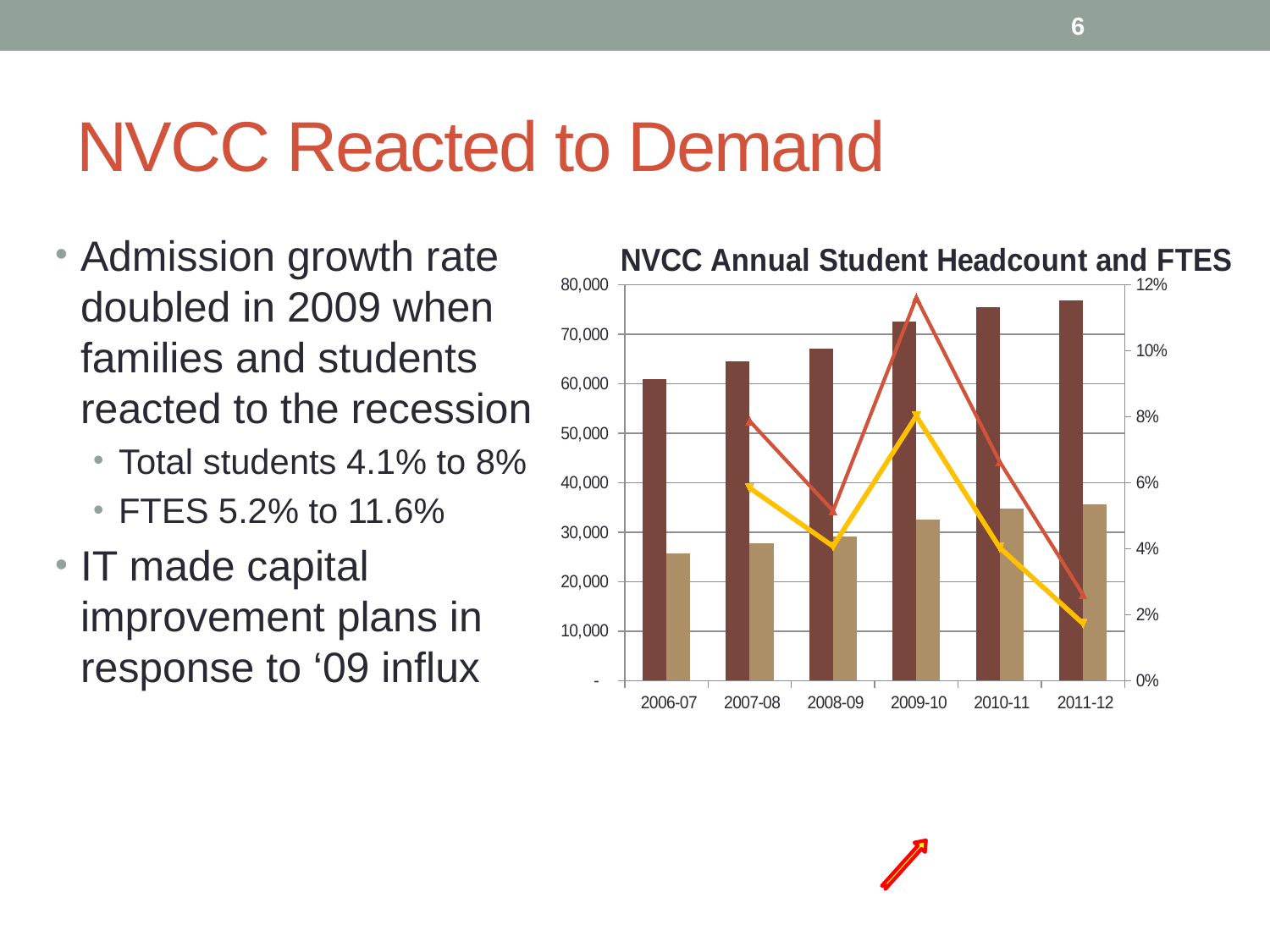
Do the tan bars rise or fall from 2006-07 to 2011-12? rise Do the dark brown bars rise or fall from 2006-07 to 2011-12? rise In which year are the dark brown bars highest? 2011-12 What kind of chart is shown on the slide? A combination bar and line chart Is the dark brown bar for 2009-10 greater or less than 70,000? greater How many academic years are shown on the x axis of the chart? 6 In which year are the dark brown bars lowest? 2006-07 Is the tan bar for 2011-12 greater or less than 40,000? less In which year is the yellow line at its lowest point? 2011-12 What is the title of the chart on the slide? NVCC Annual Student Headcount and FTES Is the red line value for 2009-10 greater or less than 10%? greater In which year does the red line reach its peak? 2009-10